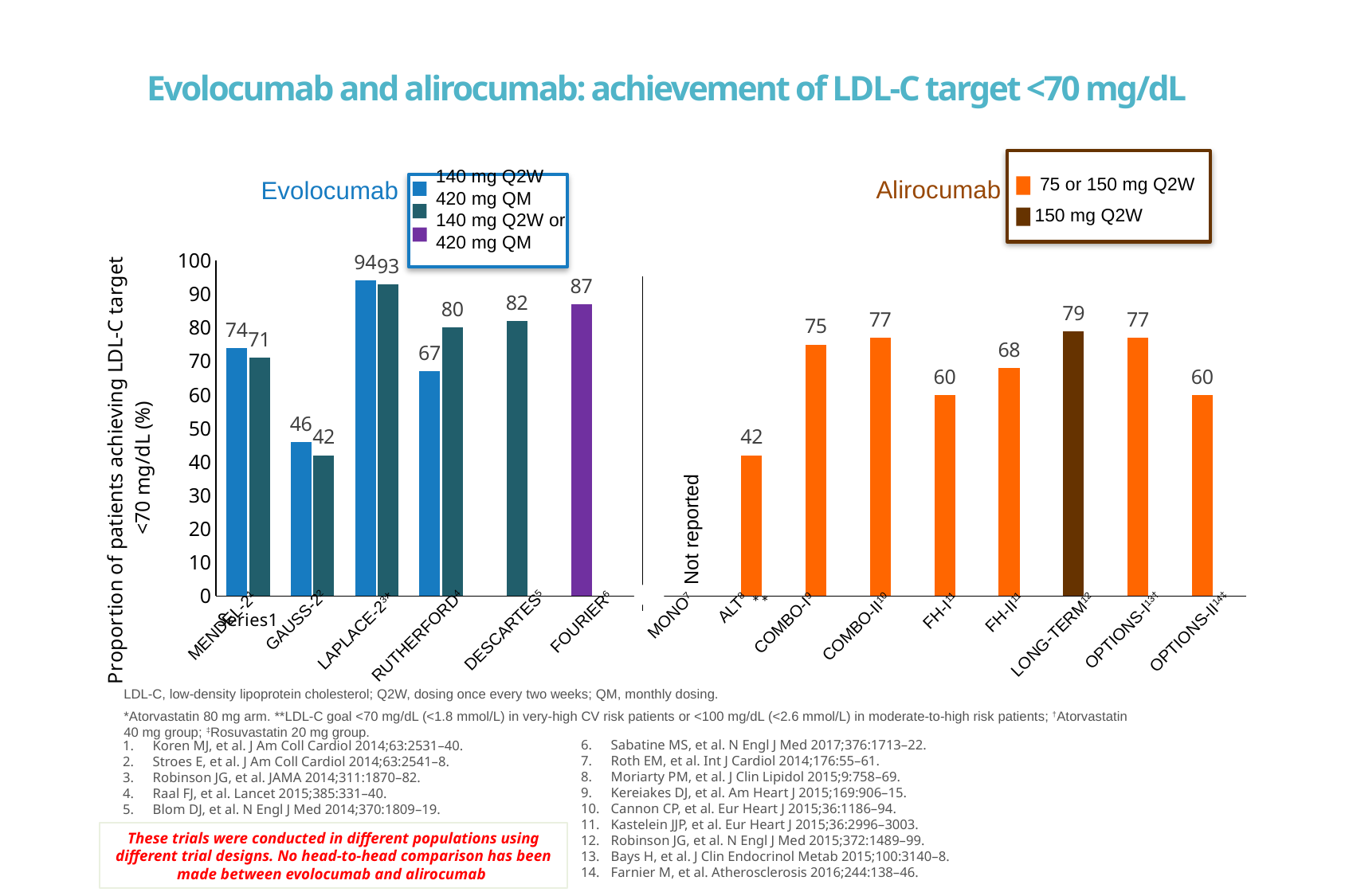
What is the value for the 420 mg QM series in the RUTHERFORD trial? 80 How many series does the evolocumab legend list? 3 Which evolocumab trial has the highest proportion of patients achieving the LDL-C target? LAPLACE-2 Which is larger: the COMBO-II value or the FH-II value? COMBO-II What is the value for the FOURIER trial? 87 What is the value for the 140 mg Q2W series in the MENDEL-2 trial? 74 Which alirocumab trial has the lowest reported proportion of patients achieving the LDL-C target? ALT How many alirocumab trials are shown on the x axis? 9 What is the value for the LONG-TERM trial in the alirocumab section? 79 What kind of chart is shown on the slide? Bar chart What is reported for the MONO trial in the alirocumab section? Not reported What is the difference between the 420 mg QM and 140 mg Q2W values in the RUTHERFORD trial? 13